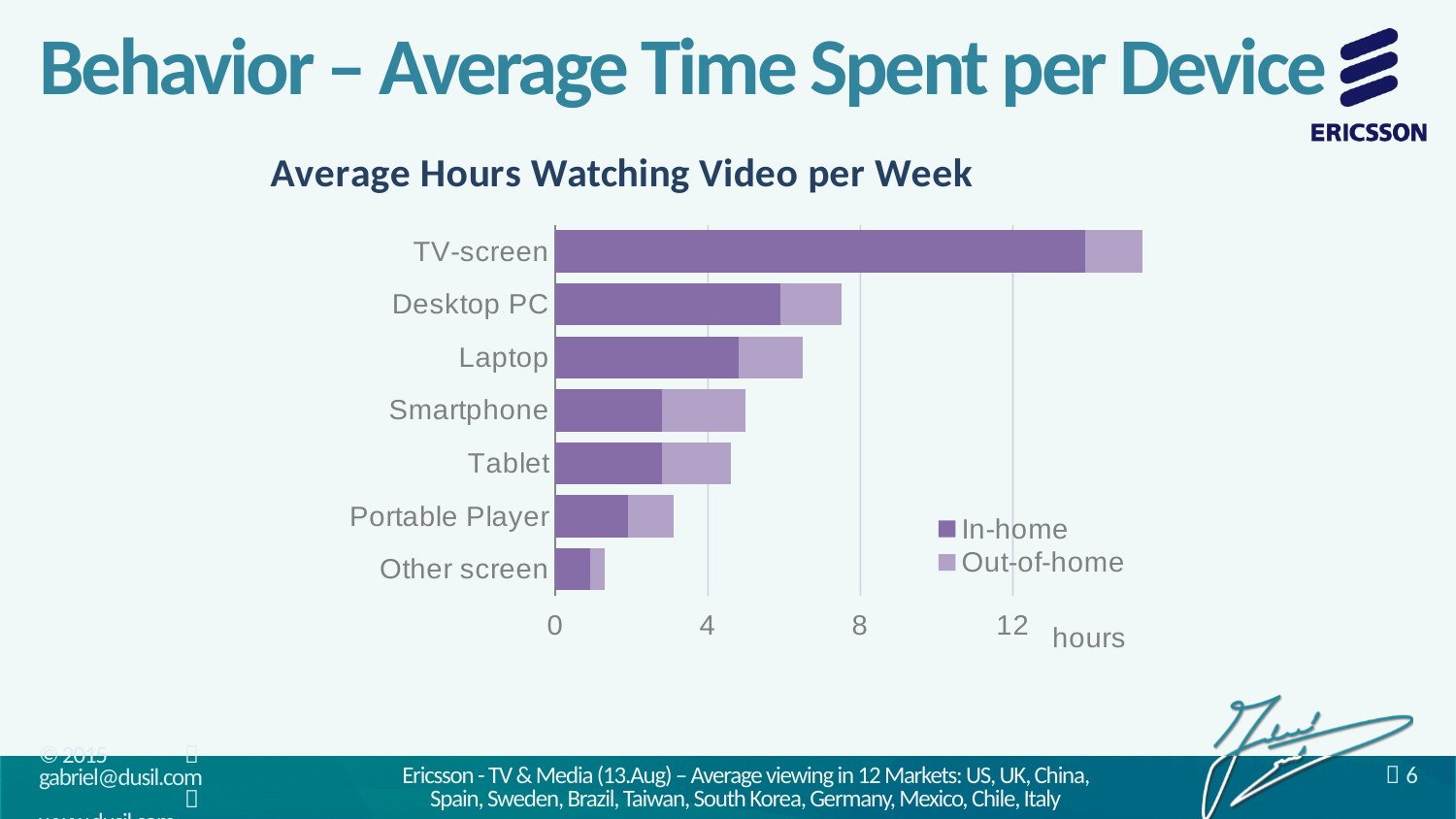
Is the total value for Desktop PC greater or less than 8 hours? less Which device has the lowest total average hours watching video per week? Other screen Which device has the highest total average hours watching video per week? TV-screen Is the total value for Laptop greater or less than 4 hours? greater What is the title of the chart? Average Hours Watching Video per Week Is the In-home value for TV-screen greater or less than 12 hours? greater Which has a larger total bar, Desktop PC or Laptop? Desktop PC How many device categories are shown in the chart? 7 What kind of chart is shown on the slide? bar chart How many series does the chart legend list? 2